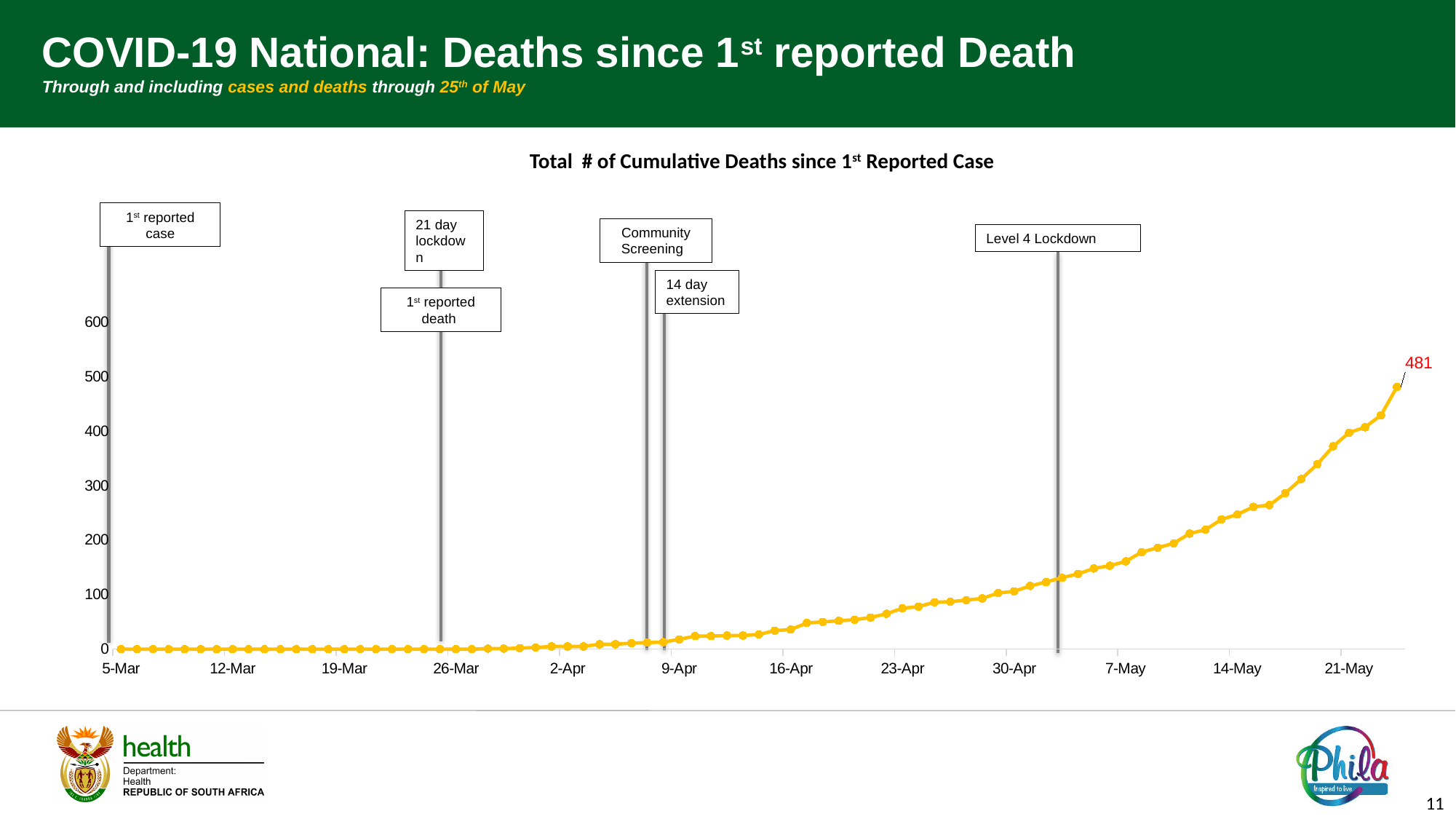
How many date labels are shown on the x axis? 12 What is the value of the last data point labelled on the chart? 481 Which date has the larger value, 7-May or 14-May? 14-May What is the highest tick value shown on the y axis? 600 What is the title of the chart? Total # of Cumulative Deaths since 1st Reported Case Is the value on 7-May greater or less than 200? less Is the value on 21-May greater or less than 300? greater What kind of chart is shown on the slide? line chart Is the value on 14-May greater or less than 200? greater Is the highest value on the chart at the start or the end of the period? end Do the cumulative deaths rise or fall along the x axis from 5-Mar to the end of the period? rise